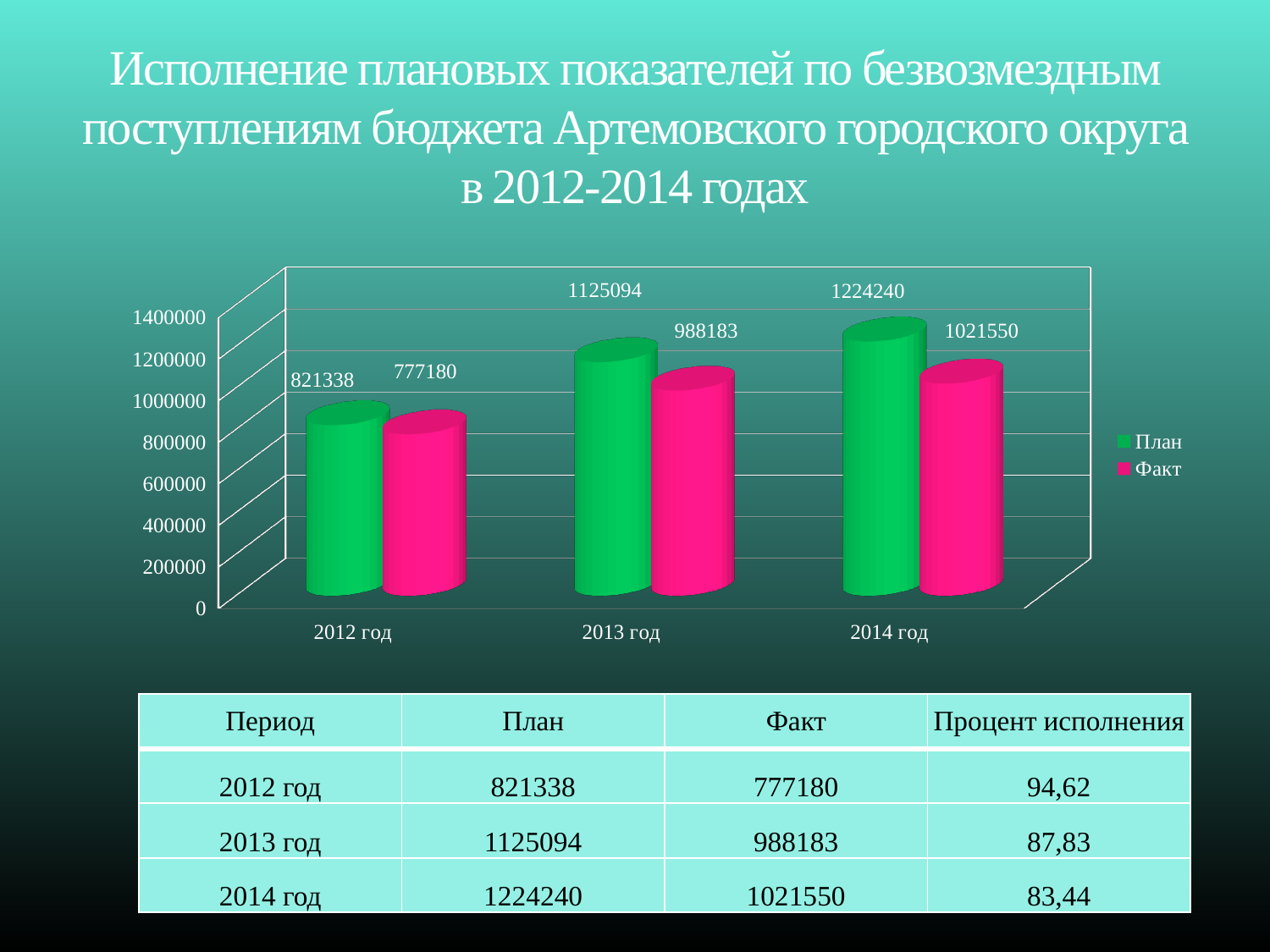
Do the Факт values rise or fall from 2012 год to 2014 год? rise What is the difference between План and Факт for 2014 год? 202690 What is the Факт value for 2014 год? 1021550 What is the План value for 2013 год? 1125094 Which year has the highest План value? 2014 год What is the difference between the План values for 2013 год and 2012 год? 303756 Which is larger for 2013 год, План or Факт? План Which year has the lowest Факт value? 2012 год What kind of chart is shown on the slide? bar chart How many years are shown on the x axis? 3 What is the Факт value for 2012 год? 777180 How many series does the legend list? 2